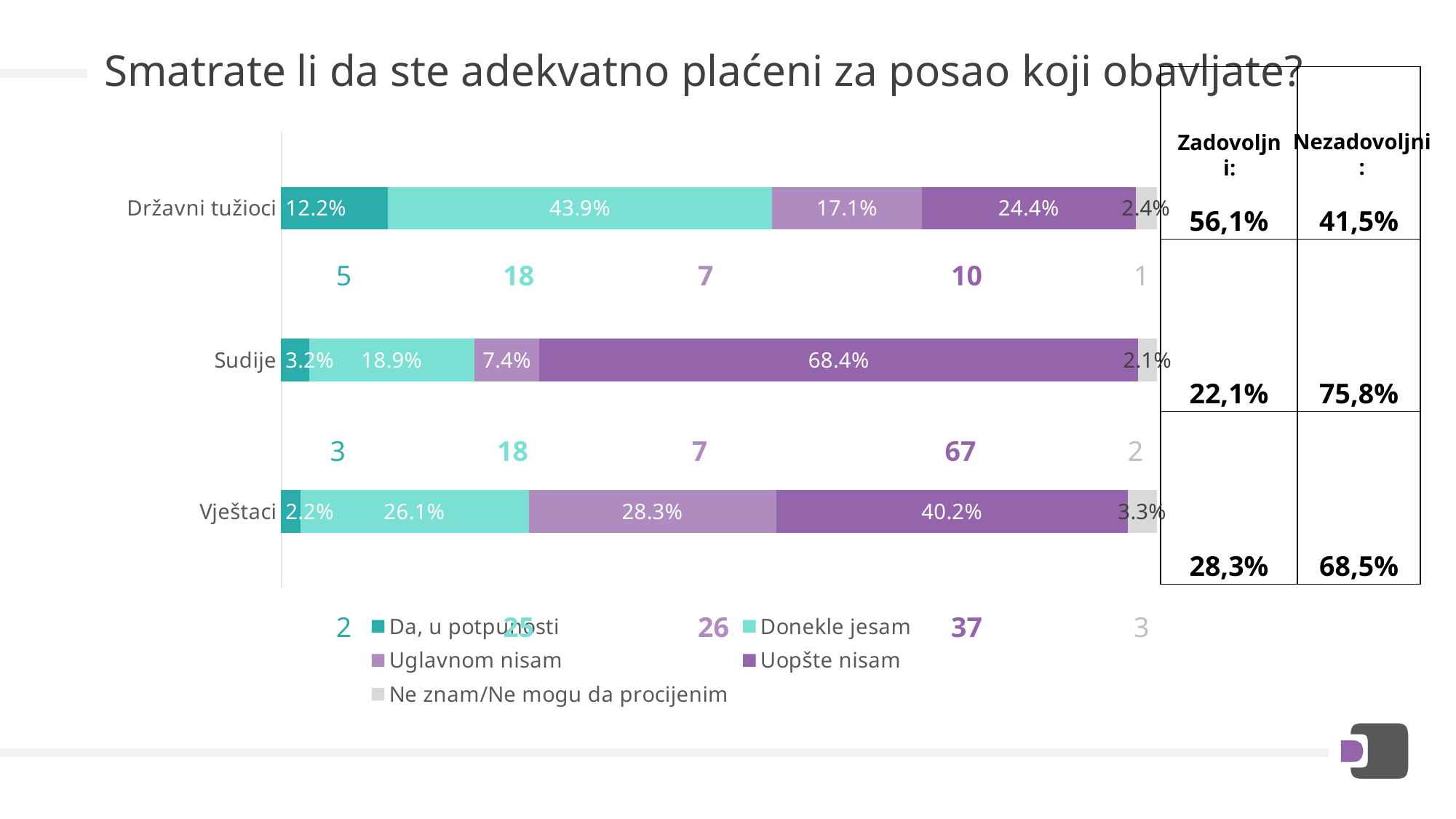
Which category has the highest value for "Uopšte nisam"? Sudije What is the value for "Da, u potpunosti" for Sudije? 3.2% How many categories (groups of respondents) are plotted on the chart? 3 What is the value for "Donekle jesam" for Državni tužioci? 43.9% What is the difference between the "Uopšte nisam" values for Sudije and Vještaci? 28.2% How many series does the chart legend list? 5 Which is larger: the "Donekle jesam" value for Državni tužioci or for Vještaci? Državni tužioci What kind of chart is shown on the slide? Stacked bar chart Which legend entry is shown in light grey? Ne znam/Ne mogu da procijenim Which category has the lowest value for "Da, u potpunosti"? Vještaci What is the value for "Uopšte nisam" for Sudije? 68.4% What is the value for "Uglavnom nisam" for Vještaci? 28.3%